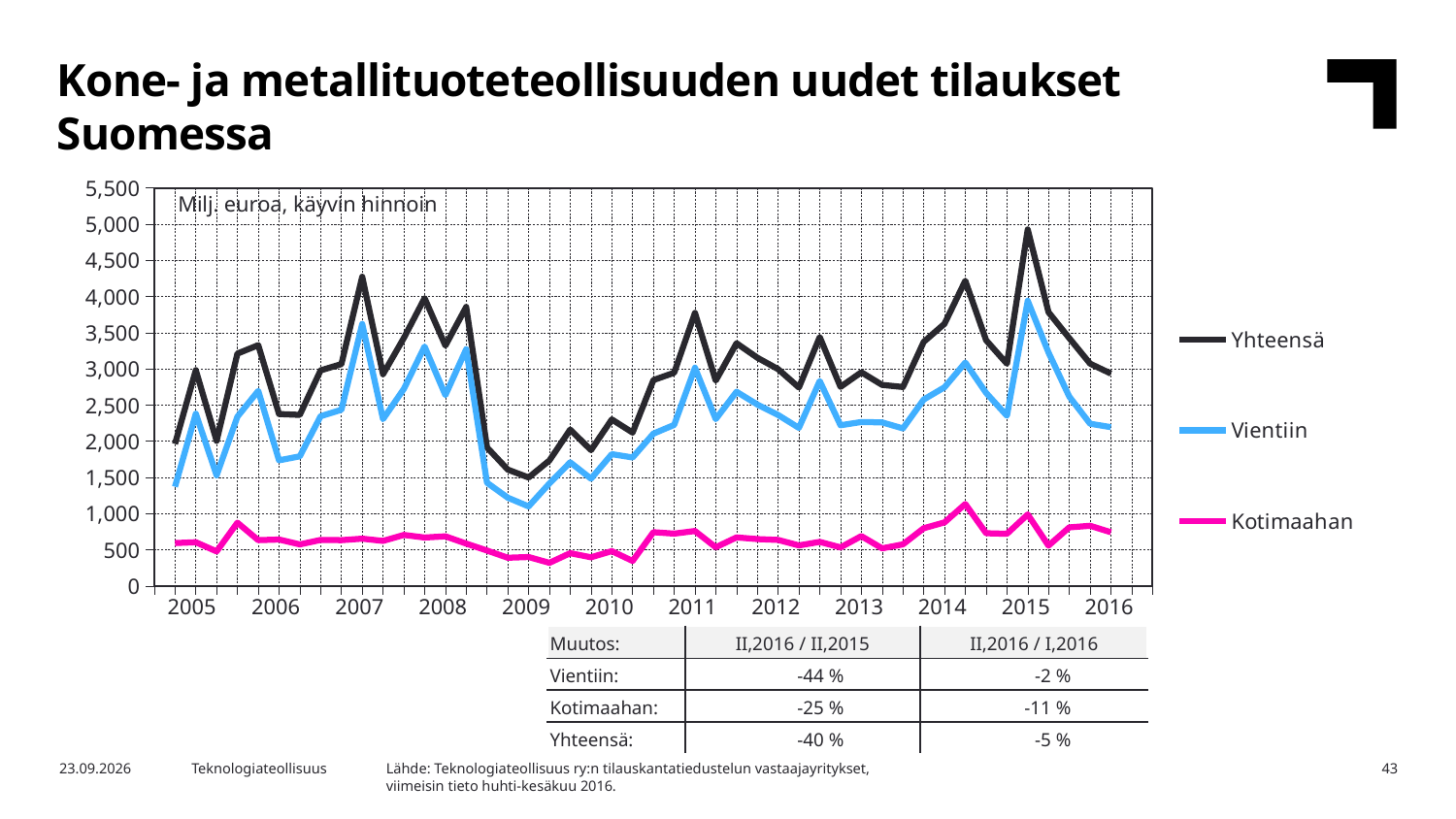
What type of chart is shown on the slide? line chart Does the Yhteensä line rise or fall from its 2015 peak to 2016? fall Which series has the lowest values throughout the chart? Kotimaahan Which series has the highest values throughout the chart? Yhteensä Which series is higher in 2011, Vientiin or Kotimaahan? Vientiin How many years are labelled on the x axis of the chart? 12 Is the peak value of Yhteensä in 2015 greater or less than 4,500? greater What unit label is printed inside the chart area? Milj. euroa, käyvin hinnoin Is the value for Kotimaahan in 2009 greater or less than 1,000? less Is the lowest value for Vientiin in 2009 greater or less than 1,500? less What are the three series named in the chart legend? Yhteensä, Vientiin, Kotimaahan How many series does the chart legend list? 3